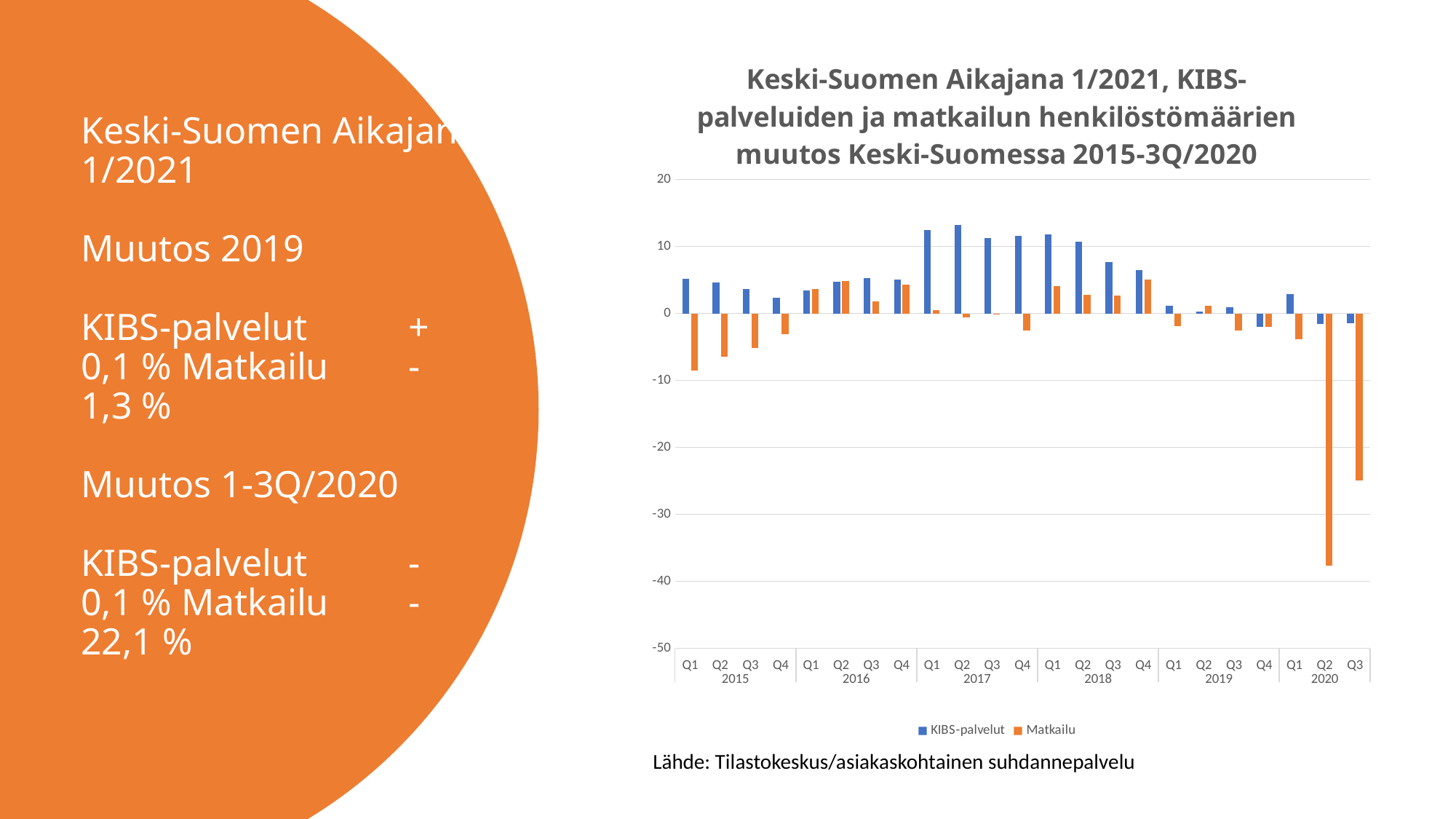
In which quarter does the Matkailu series reach its lowest value? Q2 2020 Does the Matkailu value rise or fall from Q1 2020 to Q2 2020? fall What are the two series named in the chart's legend? KIBS-palvelut and Matkailu Which colour represents the Matkailu series in the chart? orange How many quarters are plotted along the x axis of the chart? 23 Is the Matkailu value for Q1 2015 greater or less than 0? less Is the Matkailu value for Q3 2020 greater or less than -20? less Is the KIBS-palvelut value for Q2 2017 greater or less than 10? greater In Q1 2017, which series has the larger value, KIBS-palvelut or Matkailu? KIBS-palvelut What kind of chart is shown on the slide? bar chart How many series does the chart's legend list? 2